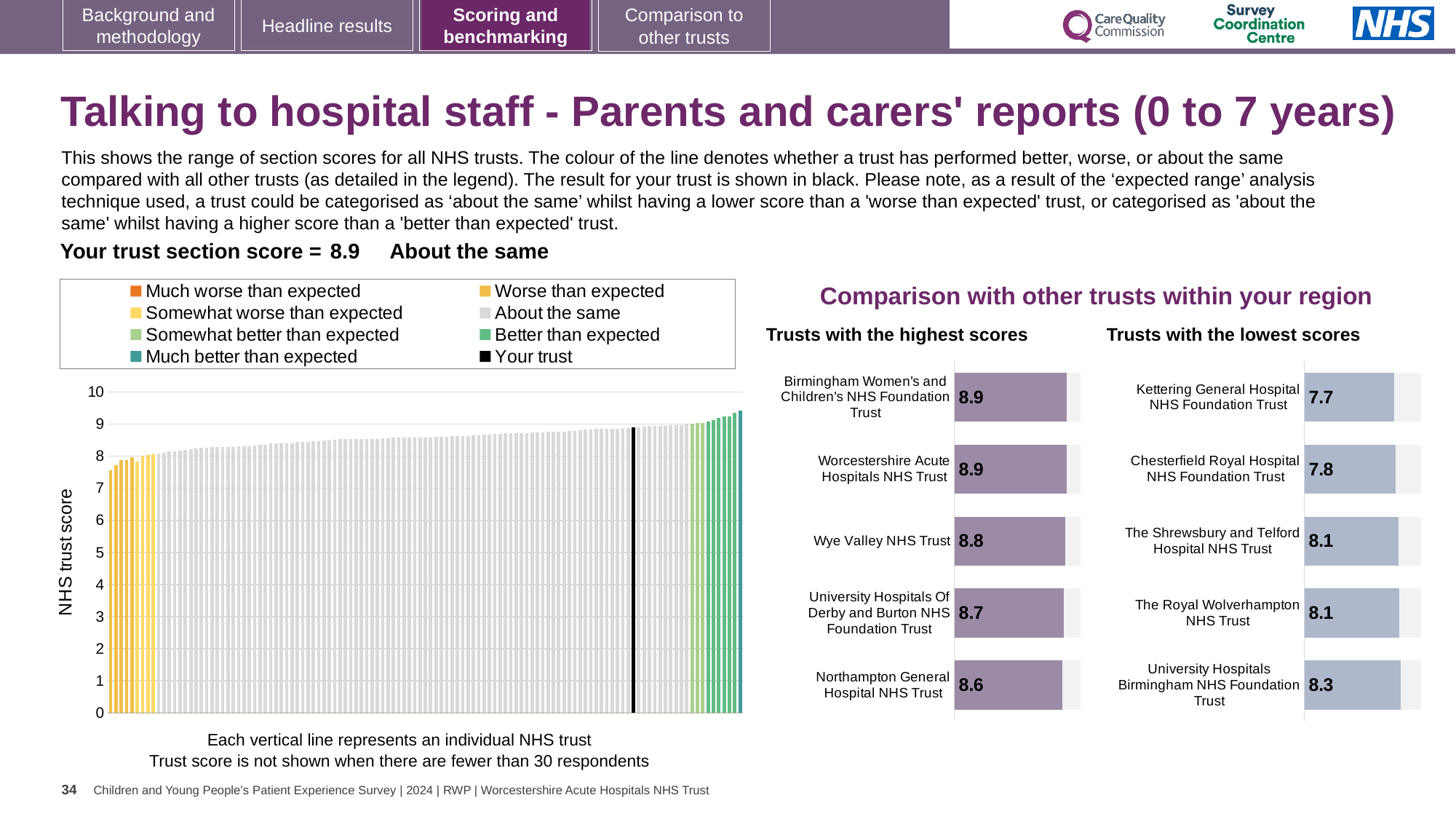
How many entries does the legend of the NHS trust score chart list? 8 In the 'Trusts with the highest scores' chart, what is the difference between the scores of Worcestershire Acute Hospitals NHS Trust and Northampton General Hospital NHS Trust? 0.3 How many trusts are listed in the 'Trusts with the highest scores' chart? 5 In the 'Trusts with the lowest scores' chart, which trust has the highest score shown? University Hospitals Birmingham NHS Foundation Trust Which is larger: the score for Chesterfield Royal Hospital NHS Foundation Trust in the lowest scores chart or the score for University Hospitals Of Derby and Burton NHS Foundation Trust in the highest scores chart? University Hospitals Of Derby and Burton NHS Foundation Trust In the 'Trusts with the highest scores' chart, what is the score for Wye Valley NHS Trust? 8.8 In the NHS trust score chart, is the value for the black 'Your trust' bar greater or less than 8? greater In the 'Trusts with the lowest scores' chart, what is the score for Kettering General Hospital NHS Foundation Trust? 7.7 In the NHS trust score chart, what colour represents 'Your trust' in the legend? Black In the 'Trusts with the lowest scores' chart, what is the difference between the scores of University Hospitals Birmingham NHS Foundation Trust and Kettering General Hospital NHS Foundation Trust? 0.6 What kind of chart is the 'NHS trust score' chart on the left? Bar chart In the 'Trusts with the highest scores' chart, which trust has the lowest score shown? Northampton General Hospital NHS Trust